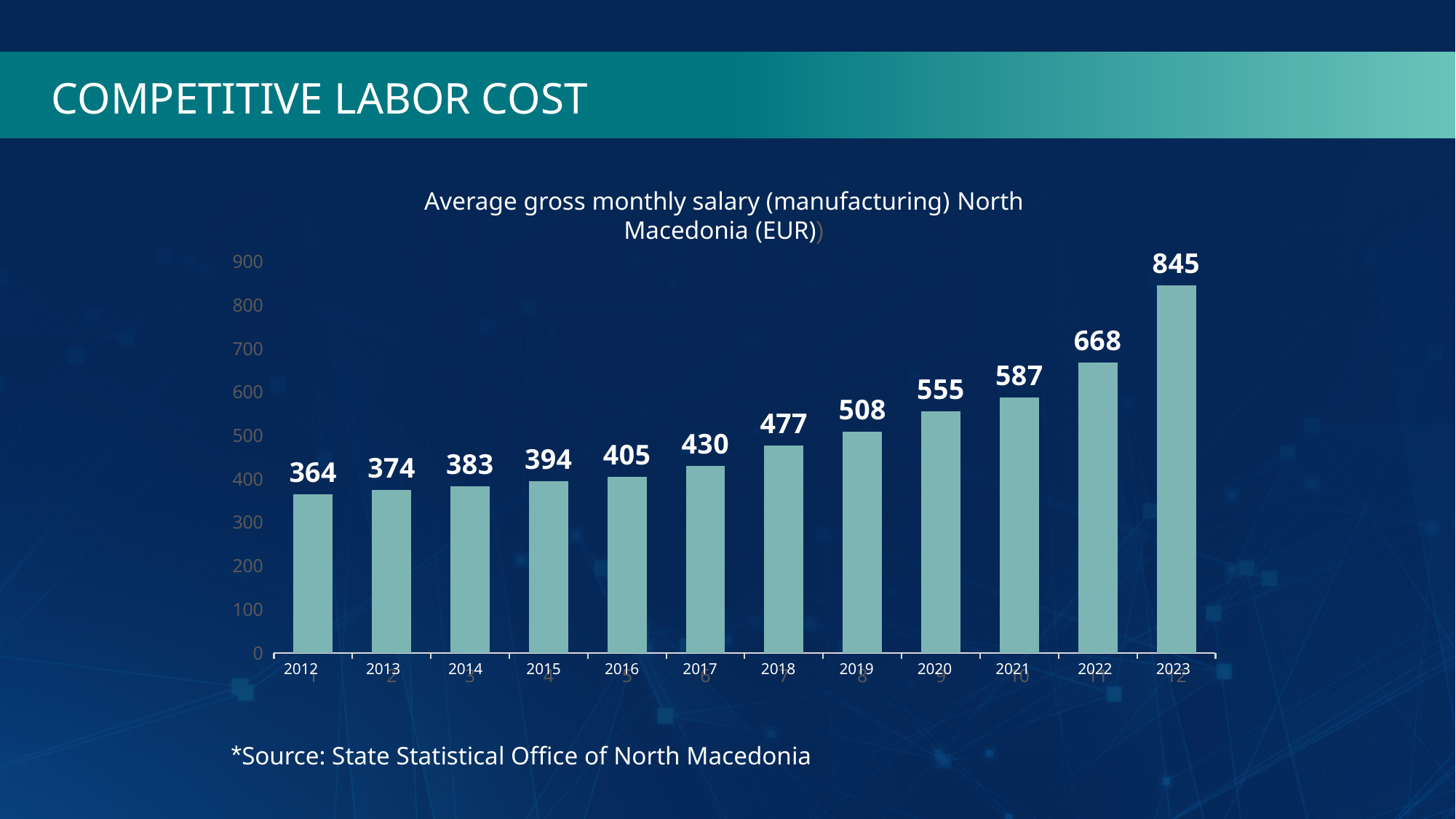
What kind of chart is shown on the slide? bar chart What is the difference between the values for 2023 and 2022? 177 What value is shown for 2018? 477 What is the average gross monthly salary shown for 2012? 364 Is the value for 2017 greater or less than 500? less What is the value for 2023? 845 How many years are shown on the x axis? 12 Do the values rise or fall from 2012 to 2023? rise Which year has the highest average gross monthly salary? 2023 What is the difference between the values for 2020 and 2012? 191 Which year has the lowest average gross monthly salary? 2012 Which year has a larger value, 2019 or 2021? 2021